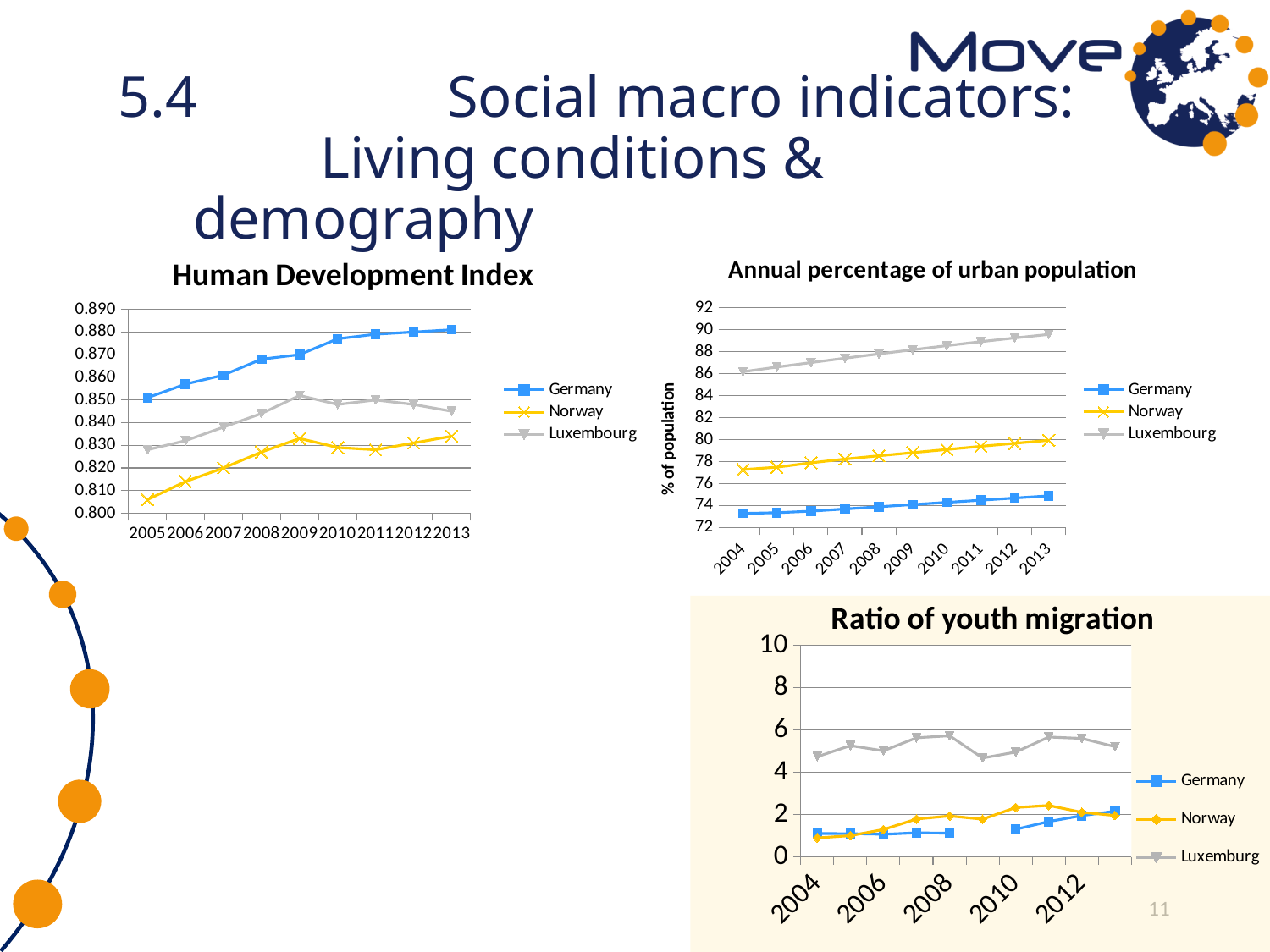
In the 'Human Development Index' chart, how many series does the legend list? 3 In the 'Human Development Index' chart, how many years are shown on the x axis? 9 In the 'Human Development Index' chart, does Germany's value rise or fall from 2005 to 2013? rise In the 'Human Development Index' chart, which country has the lowest values across all years? Norway In the 'Human Development Index' chart, which country has the highest value in 2013? Germany In the 'Human Development Index' chart, is the value for Norway in 2005 greater or less than 0.810? less What kind of chart is the 'Human Development Index' chart? line chart In the 'Ratio of youth migration' chart, which series has the highest values? Luxemburg In the 'Ratio of youth migration' chart, is the value for Germany in 2004 greater or less than 2? less In the 'Annual percentage of urban population' chart, which country has the highest values? Luxembourg In the 'Annual percentage of urban population' chart, how many years are shown on the x axis? 10 In the 'Annual percentage of urban population' chart, is the value for Germany in 2013 greater or less than 76? less